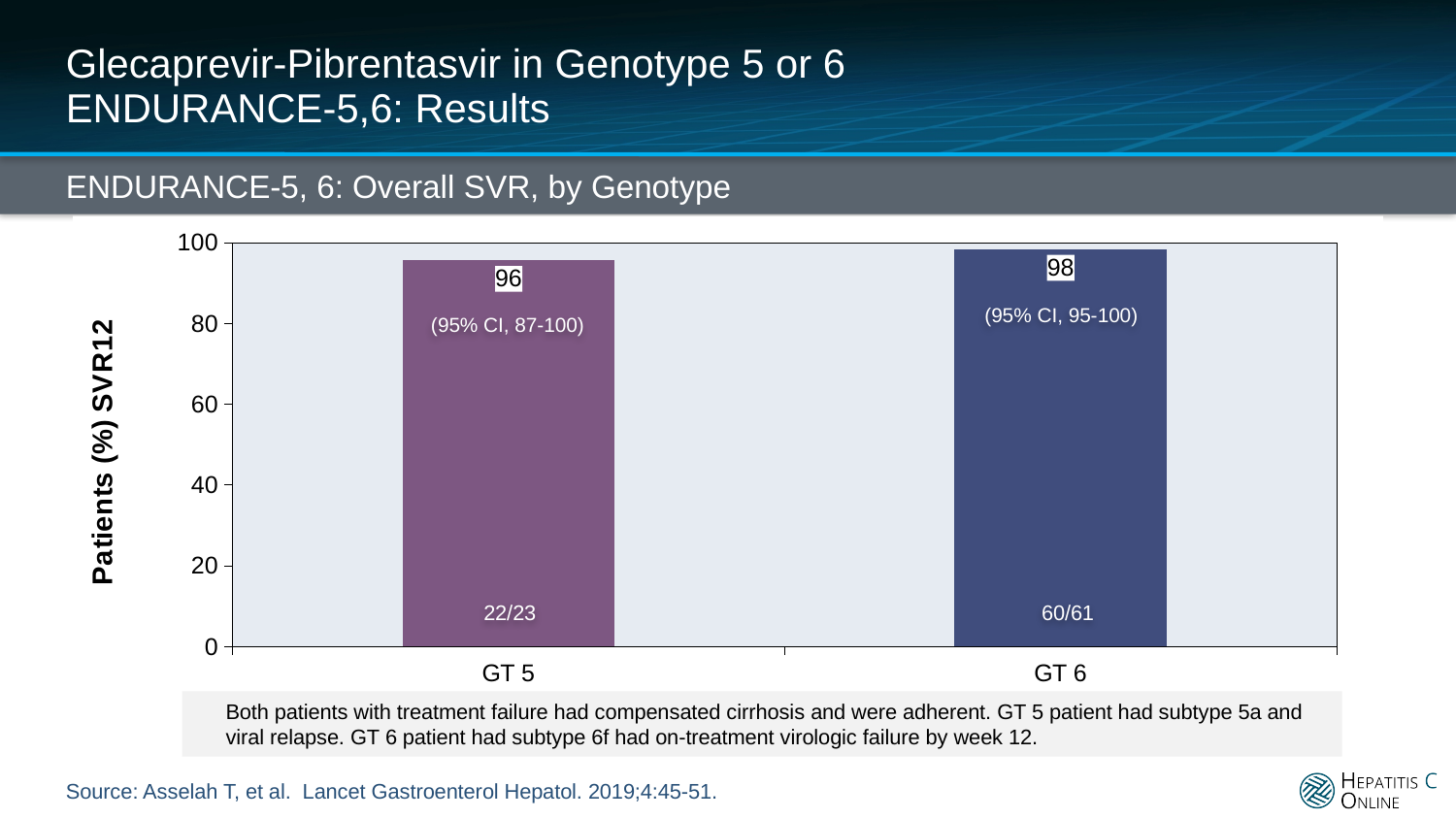
What patient fraction is printed on the GT 6 bar? 60/61 What is the SVR12 value for GT 5? 96 Is the SVR12 value for GT 5 greater or less than 80? greater What is the 95% confidence interval shown for GT 5? 87-100 What is the 95% confidence interval shown for GT 6? 95-100 What is the SVR12 value for GT 6? 98 What is the difference in SVR12 between GT 6 and GT 5? 2 How many genotype categories are shown on the x axis? 2 Which genotype has the higher SVR12 rate? GT 6 What is the label of the y axis? Patients (%) SVR12 Which genotype has the lower SVR12 rate? GT 5 What kind of chart is shown on the slide? Bar chart